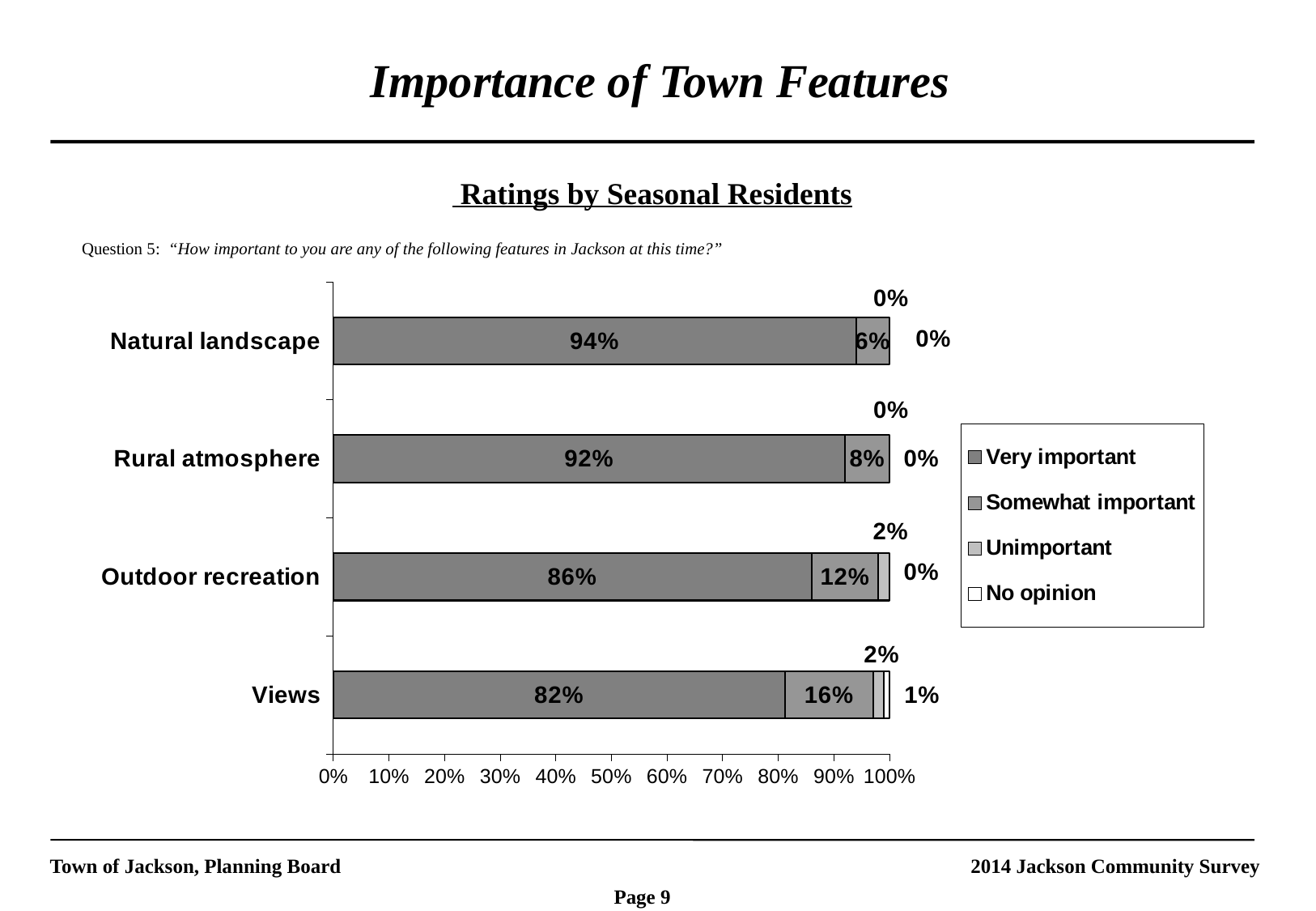
Which feature has the highest Very important percentage? Natural landscape Which feature has the lowest Very important percentage? Views What kind of chart is shown on the slide? Stacked bar chart What is the No opinion value for Views? 1% What is the difference between the Very important values for Natural landscape and Views? 12% Which has a larger Somewhat important value, Rural atmosphere or Outdoor recreation? Outdoor recreation How many features are listed on the chart? 4 What is the Somewhat important value for Views? 16% What is the Unimportant value for Outdoor recreation? 2% What is the subtitle above the chart? Ratings by Seasonal Residents How many series does the legend list? 4 What percentage of seasonal residents rated Natural landscape as Very important? 94%